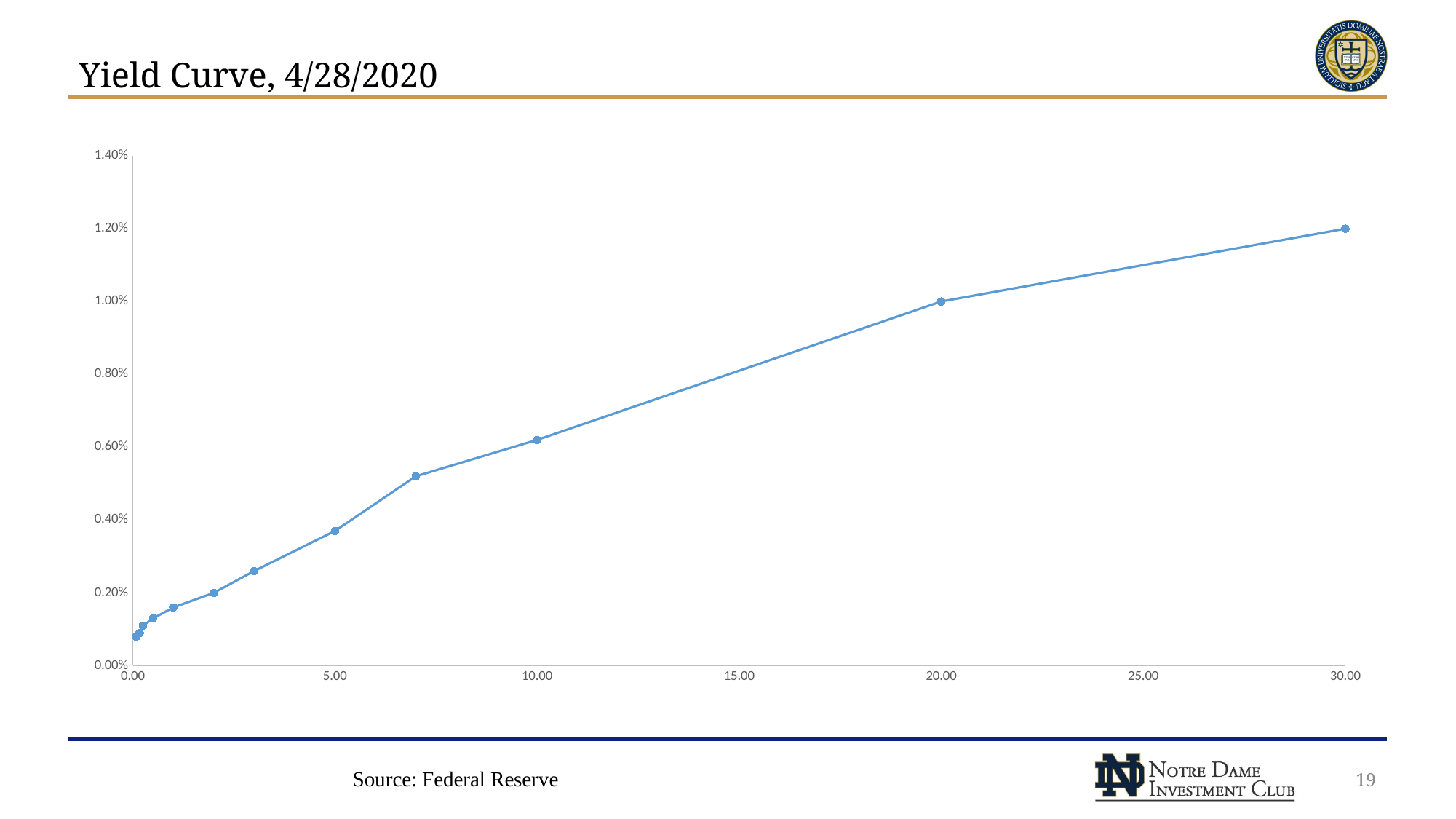
Do the plotted values rise or fall as the x axis increases from 0.00 to 30.00? rise What is the highest value shown on the y axis? 1.40% Is the value at x = 5.00 greater or less than 0.20%? greater What source is cited for the chart? Federal Reserve Is the value at x = 30.00 greater or less than 1.00%? greater What kind of chart is shown on the slide? line chart Is the value at x = 10.00 greater or less than 0.80%? less At which x-axis value is the plotted yield highest? 30.00 What is the title of the chart on the slide? Yield Curve, 4/28/2020 Which is larger, the value at x = 20.00 or the value at x = 10.00? x = 20.00